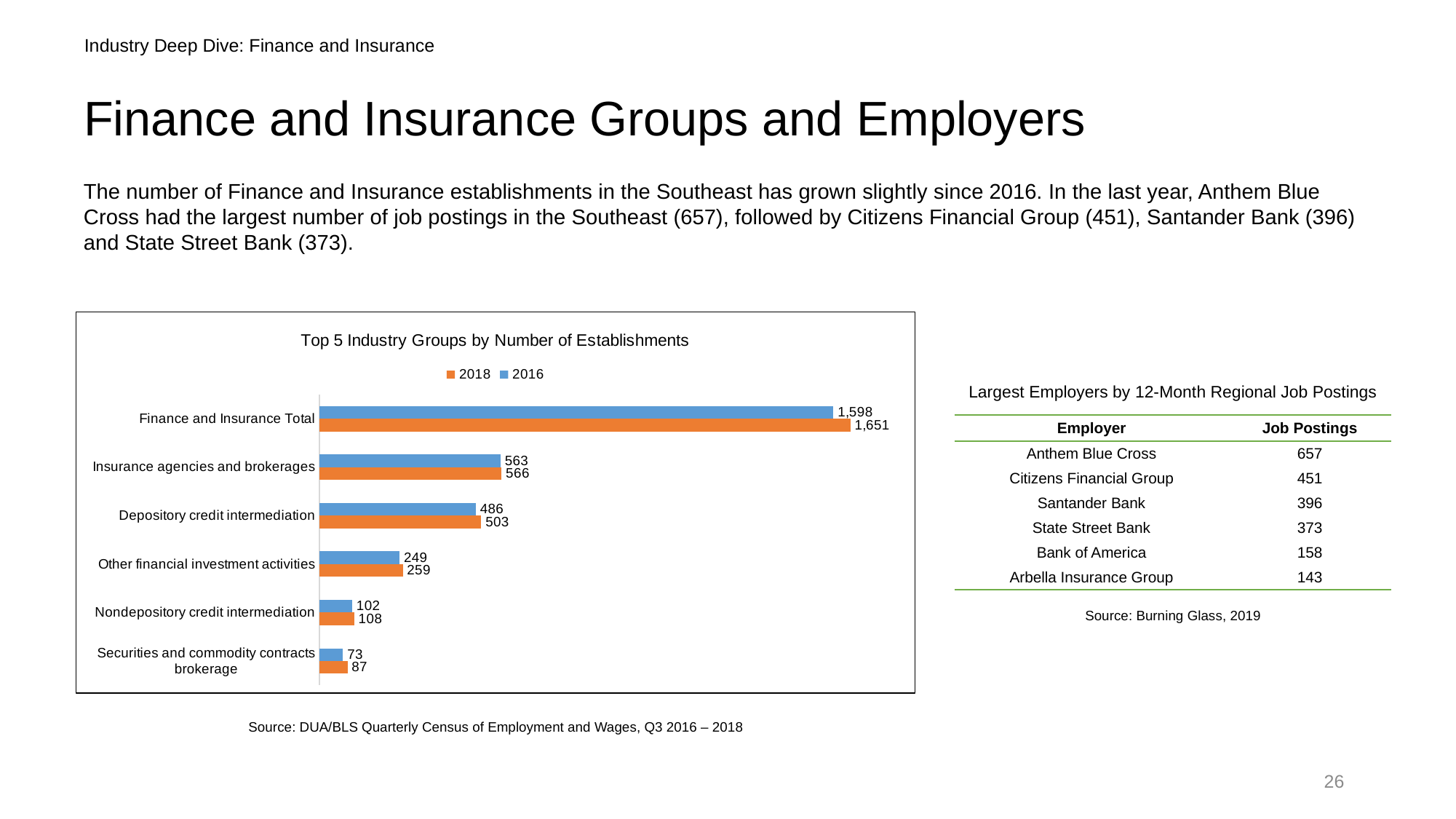
What kind of chart is 'Top 5 Industry Groups by Number of Establishments'? bar chart In the 'Top 5 Industry Groups by Number of Establishments' chart, what is the difference between the 2018 and 2016 values for Finance and Insurance Total? 53 How many categories are shown in the 'Top 5 Industry Groups by Number of Establishments' chart? 6 In the 'Top 5 Industry Groups by Number of Establishments' chart, is the 2018 value for Insurance agencies and brokerages larger than the 2018 value for Depository credit intermediation? Yes What is the 2018 value for Securities and commodity contracts brokerage in the 'Top 5 Industry Groups by Number of Establishments' chart? 87 In the 'Top 5 Industry Groups by Number of Establishments' chart, which category has the highest 2018 value? Finance and Insurance Total In the 'Top 5 Industry Groups by Number of Establishments' chart, which category has the lowest 2016 value? Securities and commodity contracts brokerage What is the 2016 value for Nondepository credit intermediation in the 'Top 5 Industry Groups by Number of Establishments' chart? 102 What is the 2016 value for Depository credit intermediation in the 'Top 5 Industry Groups by Number of Establishments' chart? 486 Which colour represents the 2018 series in the 'Top 5 Industry Groups by Number of Establishments' chart? Orange What is the 2018 value for Finance and Insurance Total in the 'Top 5 Industry Groups by Number of Establishments' chart? 1,651 How many series does the legend of the 'Top 5 Industry Groups by Number of Establishments' chart list? 2